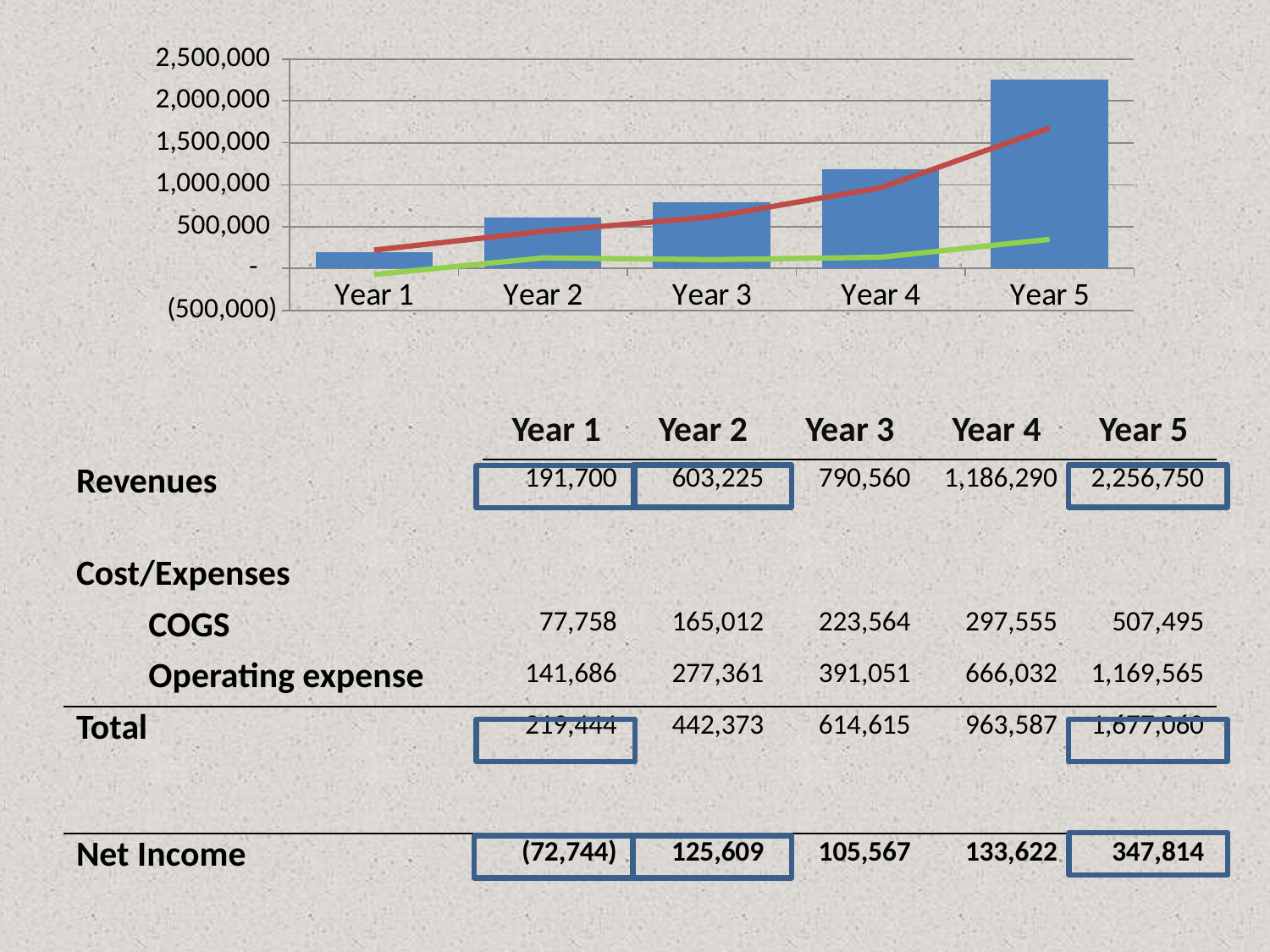
Is the bar value for Year 4 greater or less than 1,000,000? greater Is the bar value for Year 5 greater or less than 2,000,000? greater Do the bar values rise or fall from Year 1 to Year 5? rise Is the green line's value at Year 1 greater or less than 0? less What kind of chart is shown on the slide? bar chart with two line series Which year has the tallest bar in the chart? Year 5 Which is larger at Year 5, the bar or the red line? the bar How many categories are shown on the x axis of the chart? 5 Which year has the shortest bar in the chart? Year 1